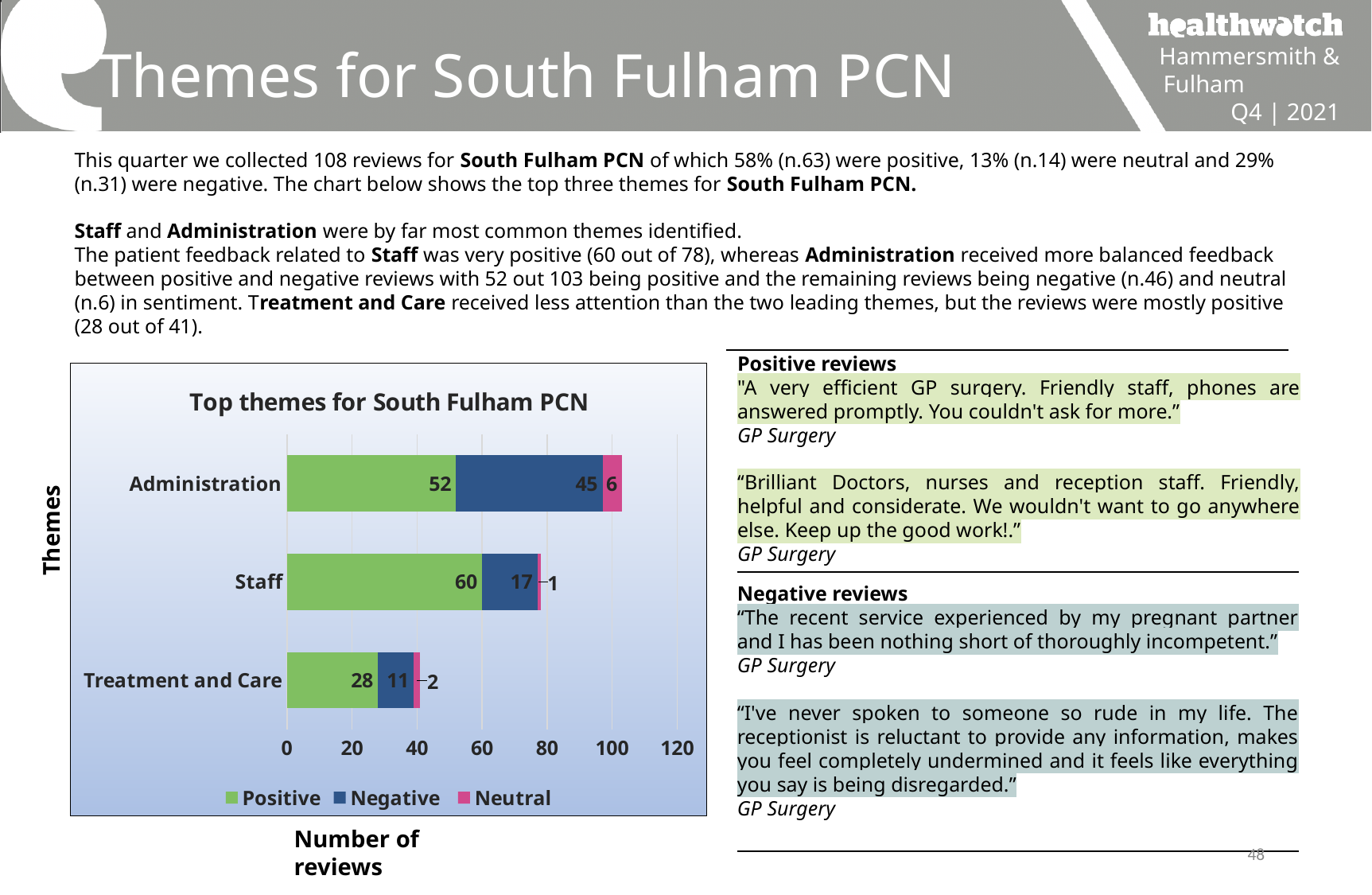
How many themes are shown in the chart? 3 What is the Positive value for Administration? 52 What is the difference between the Negative values for Administration and Staff? 28 What type of chart is shown? Stacked bar chart What is the total number of reviews in the Treatment and Care bar? 41 What is the total number of reviews in the Administration bar? 103 Which theme has the lowest Negative value? Treatment and Care Which theme has the highest Positive value? Staff What is the Negative value for Staff? 17 How many series does the legend list? 3 Which is larger, the Positive value for Administration or the Positive value for Staff? Staff What is the Neutral value for Treatment and Care? 2